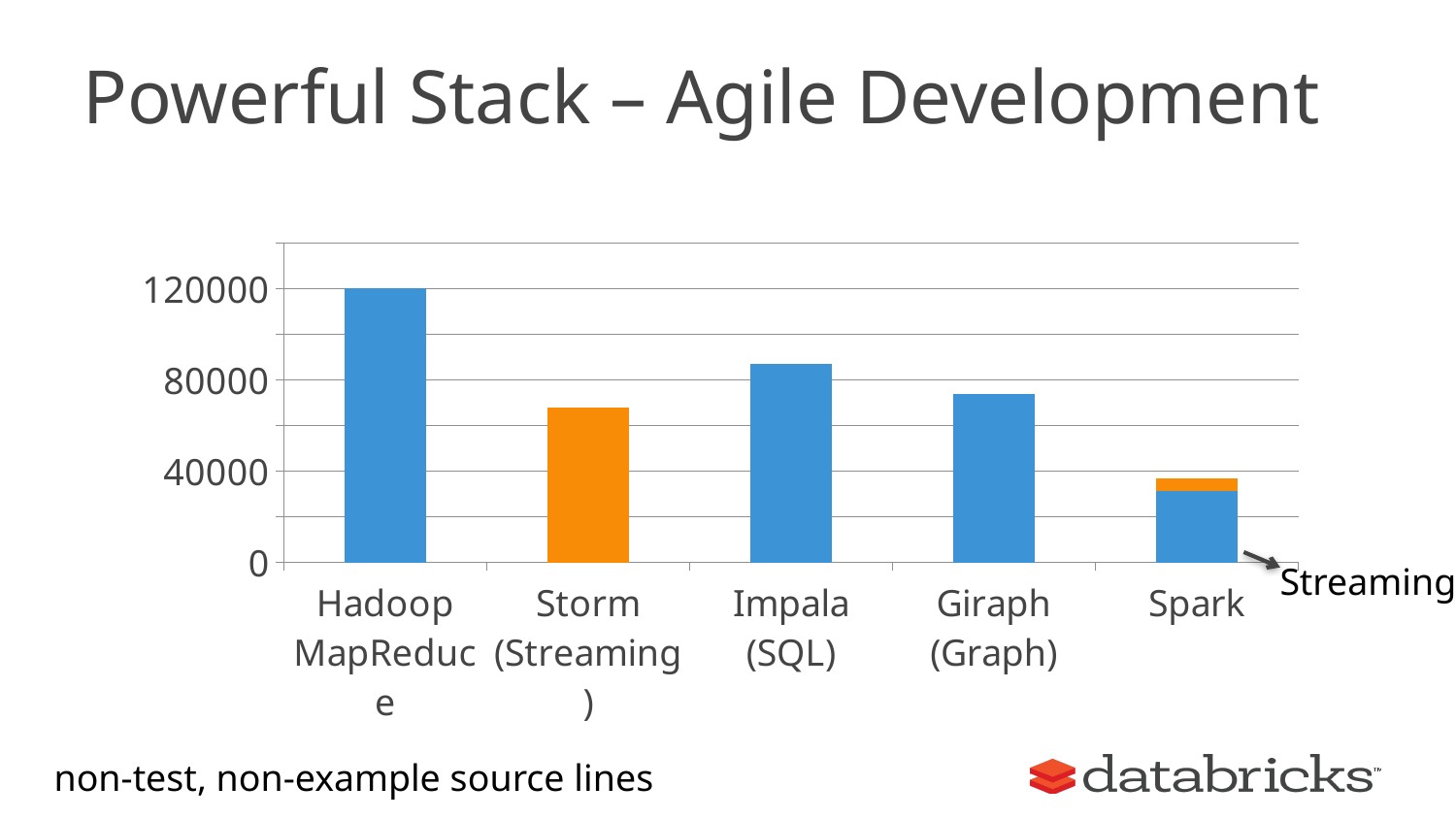
Which category has the highest value? Hadoop MapReduce How many categories are plotted on the chart? 5 Is the value for Impala (SQL) greater or less than 80000? greater Is the value for Giraph (Graph) greater or less than 80000? less Is the value for Storm (Streaming) greater or less than 80000? less What is the value for Hadoop MapReduce? 120000 What does the orange segment on top of the Spark bar represent, according to the annotation? Streaming Which is larger, the value for Impala (SQL) or the value for Giraph (Graph)? Impala (SQL) What kind of chart is shown on the slide? bar chart What does the caption below the chart say the values measure? non-test, non-example source lines Which category has the lowest value? Spark